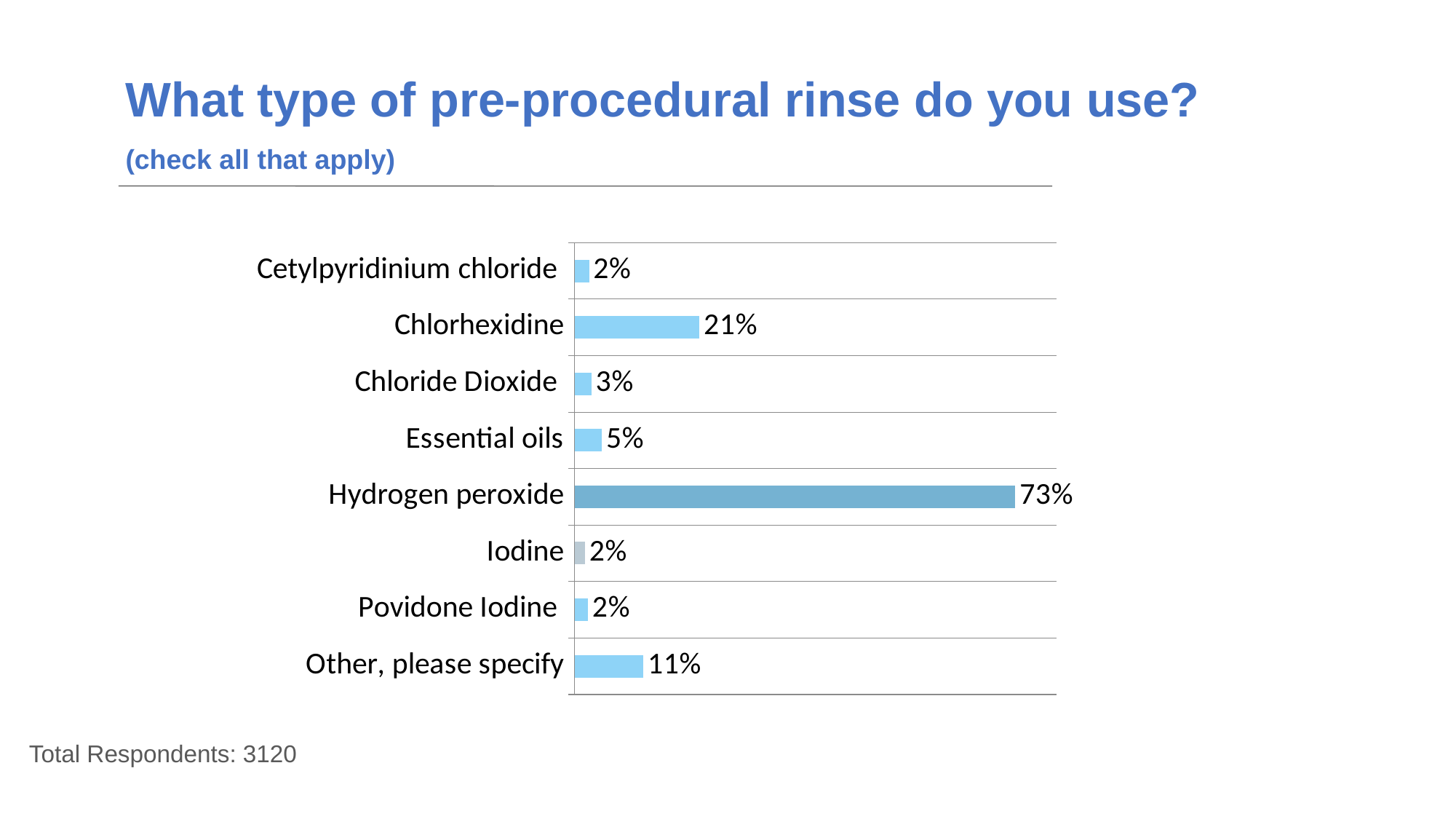
Which is larger, the value for Chloride Dioxide or the value for Essential oils? Essential oils What is the value for Other, please specify? 11% What percentage is shown for Essential oils? 5% What kind of chart is shown on the slide? Bar chart What is the difference between the Hydrogen peroxide and Chlorhexidine percentages? 52% What is the total number of respondents stated on the slide? 3120 What is the value shown for Chlorhexidine? 21% What percentage of respondents use Hydrogen peroxide as a pre-procedural rinse? 73% How many categories are shown in the chart? 8 Which pre-procedural rinse has the highest percentage? Hydrogen peroxide What is the difference between the Chlorhexidine and Other, please specify values? 10% Which bar is drawn in grey rather than blue? Iodine